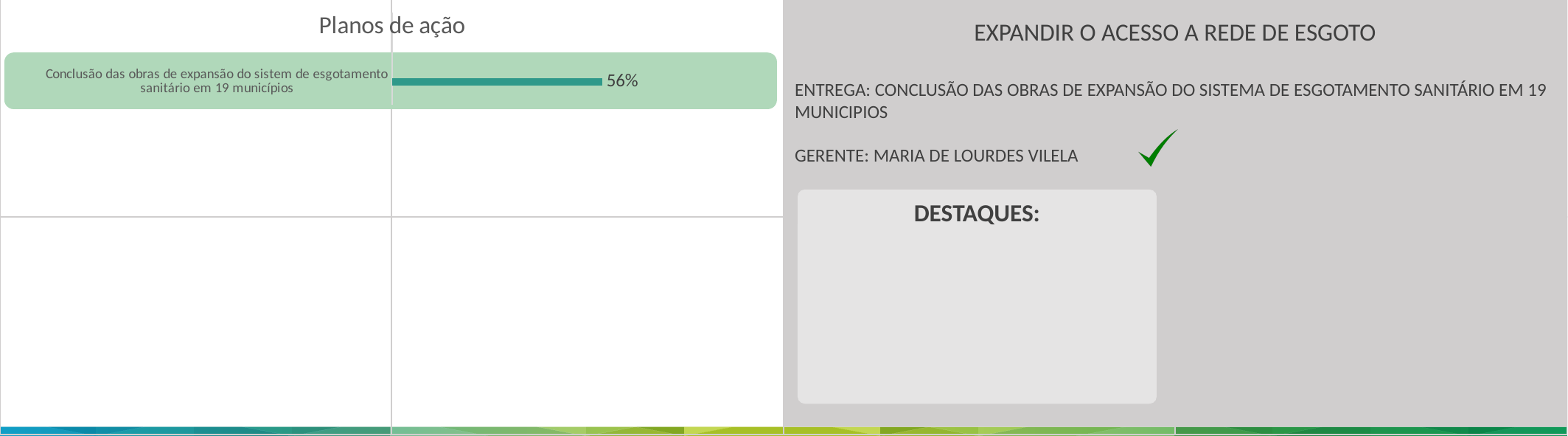
Which category has the highest value in the "Planos de ação" chart? Conclusão das obras de expansão do sistem de esgotamento sanitário em 19 municípios What value is shown for "Conclusão das obras de expansão do sistem de esgotamento sanitário em 19 municípios" in the "Planos de ação" chart? 56% What is the title of the chart on the left side of the slide? Planos de ação What kind of chart is the "Planos de ação" chart? bar chart Is the value for "Conclusão das obras de expansão do sistem de esgotamento sanitário em 19 municípios" in the "Planos de ação" chart greater or less than 50%? greater How many categories are plotted in the "Planos de ação" chart? 1 Are the bars in the "Planos de ação" chart horizontal or vertical? horizontal